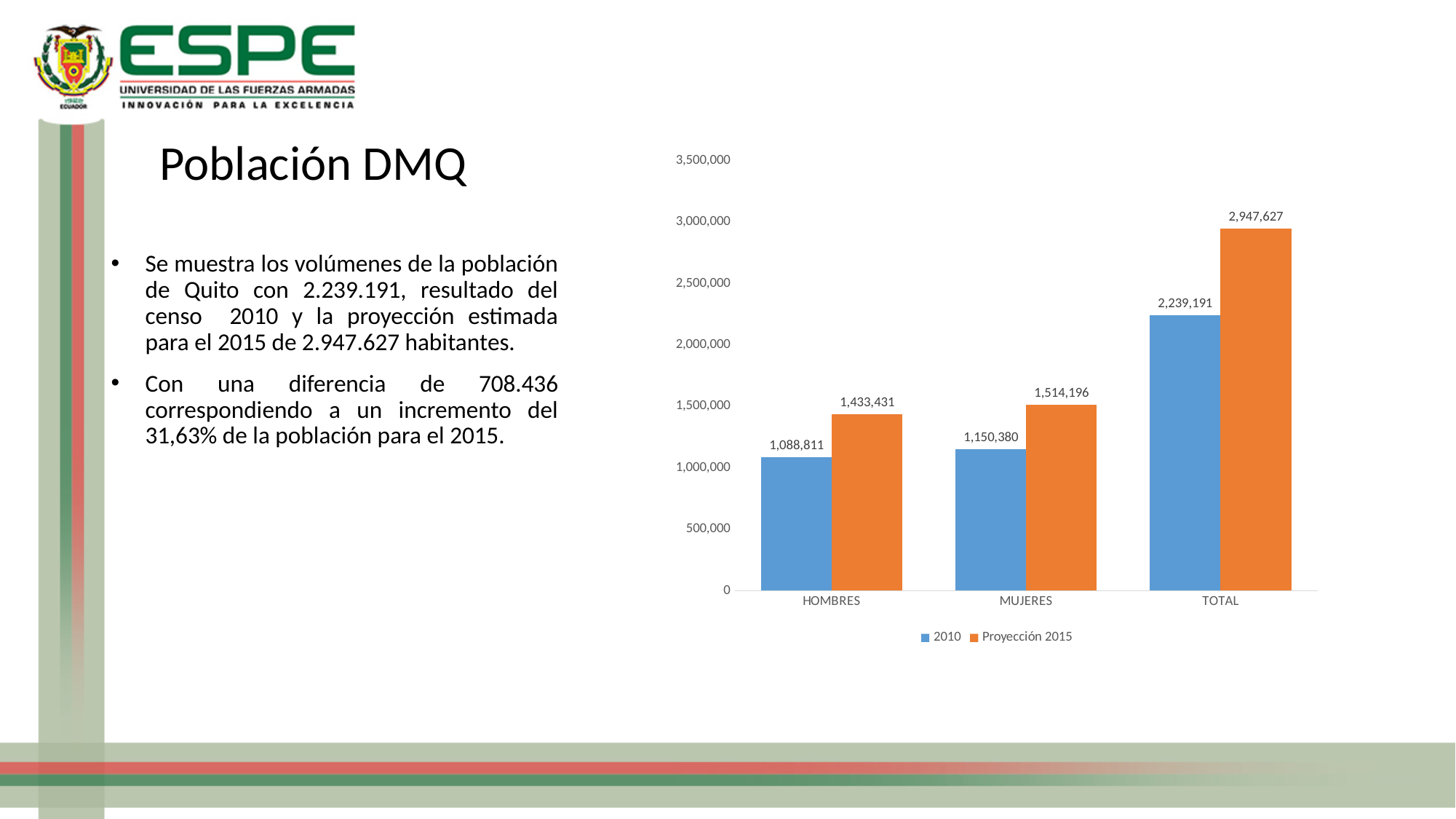
What is the 2010 value for TOTAL? 2,239,191 What is the difference between the Proyección 2015 and 2010 values for TOTAL? 708,436 How many series does the legend list? 2 Which is larger, the Proyección 2015 value for HOMBRES or for MUJERES? MUJERES What is the difference between the 2010 values for MUJERES and HOMBRES? 61,569 What is the Proyección 2015 value for MUJERES? 1,514,196 How many categories are shown on the x axis? 3 Which category has the lowest 2010 value? HOMBRES What is the Proyección 2015 value for TOTAL? 2,947,627 Which category has the highest Proyección 2015 value? TOTAL What is the 2010 value for HOMBRES? 1,088,811 What kind of chart is shown on the slide? Bar chart